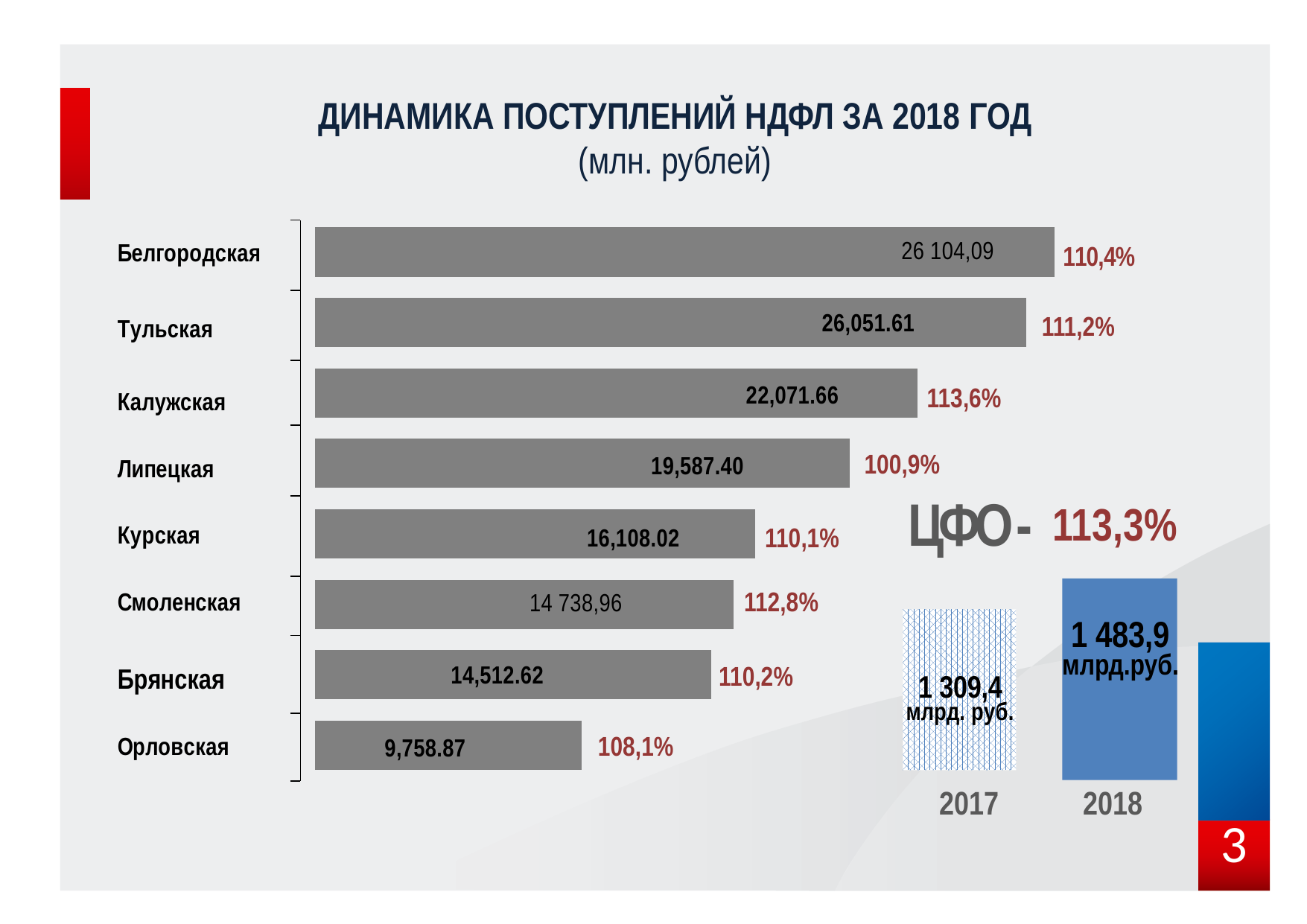
On the main bar chart, what growth percentage is shown next to Липецкая? 100,9% How many regions are shown on the main bar chart? 8 What kind of chart is the main chart on the slide? Bar chart On the small ЦФО chart at the bottom right, what is the value for 2018? 1 483,9 млрд.руб. On the main bar chart, what is the value for Орловская? 9,758.87 On the main bar chart, what is the value for Калужская? 22,071.66 On the small ЦФО chart at the bottom right, what is the difference between the 2018 and 2017 values? 174,5 млрд. руб. On the main bar chart, which region has the lowest value? Орловская On the main bar chart, what is the difference between the values for Калужская and Липецкая? 2,484.26 On the main bar chart, which is larger: the value for Курская or the value for Смоленская? Курская On the main bar chart, what is the value for Белгородская? 26 104,09 On the main bar chart, which region has the highest value? Белгородская